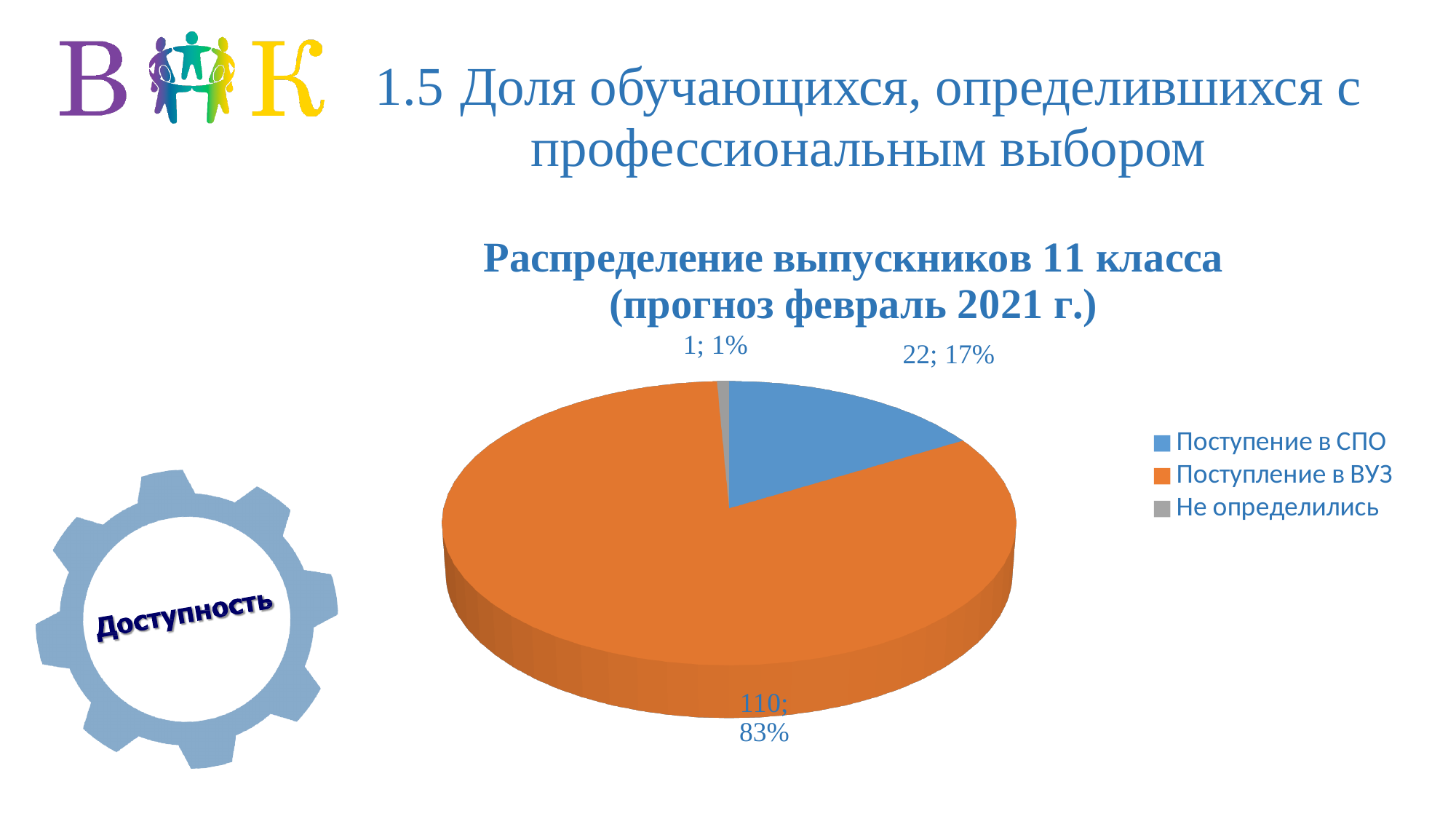
What value is shown for Поступение в СПО? 22 What share of the pie does Поступение в СПО represent? 17% How many entries does the legend list? 3 Which category has the smallest slice? Не определились What kind of chart is shown on the slide? Pie chart What is the difference between the values for Поступление в ВУЗ and Поступение в СПО? 88 Which category has the largest slice? Поступление в ВУЗ What value is shown for Не определились? 1 What value is shown for Поступление в ВУЗ? 110 What is the title of the chart? Распределение выпускников 11 класса (прогноз февраль 2021 г.) How many slices does the pie chart have? 3 What share of the pie does Поступление в ВУЗ represent? 83%